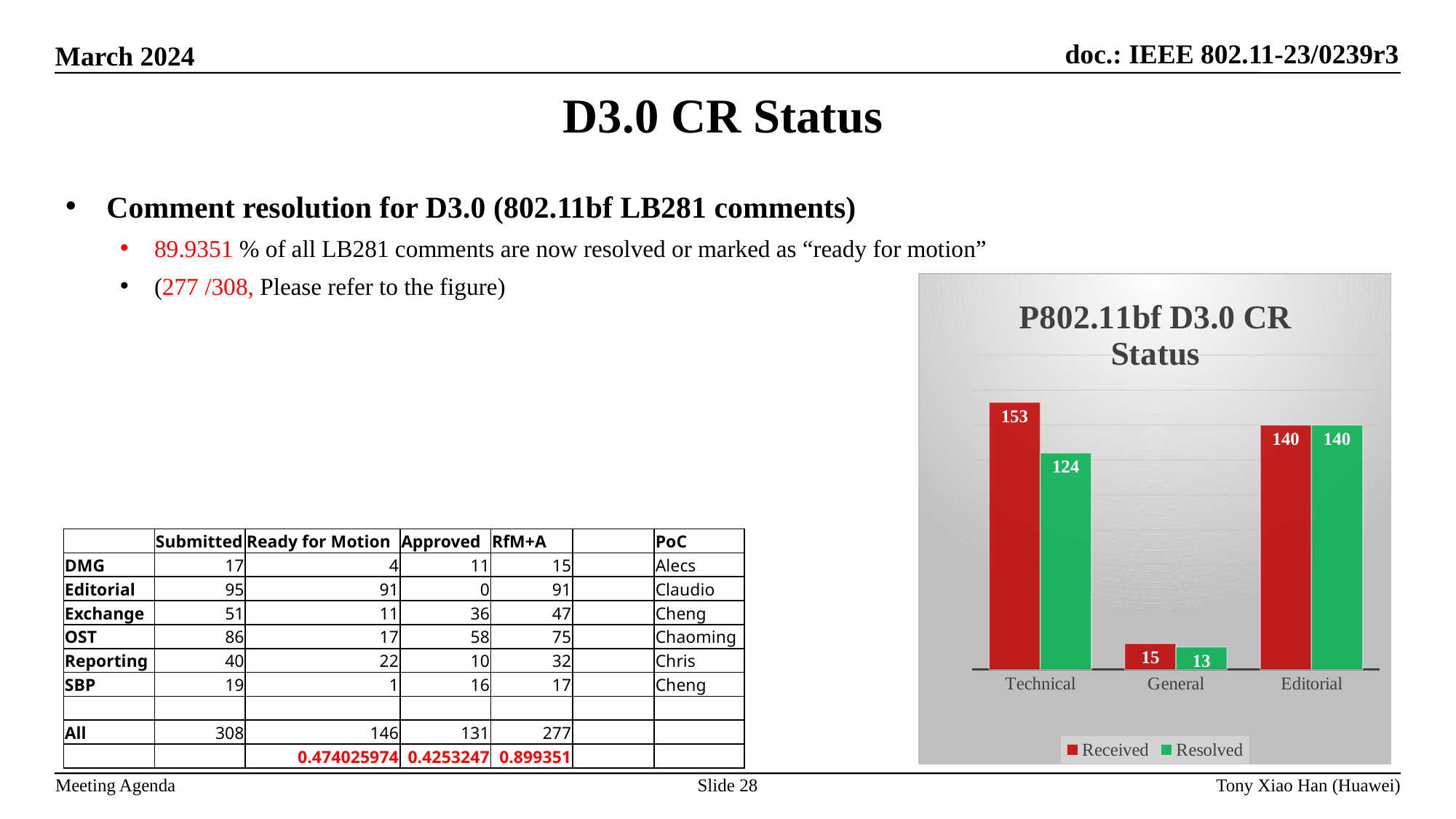
What is the Resolved value for Technical in the chart? 124 Is the Received value for Technical larger or the Received value for Editorial? Technical What is the difference between Received and Resolved for Technical in the chart? 29 What is the difference between Received and Resolved for General in the chart? 2 How many series does the chart legend list? 2 Which category has the lowest Resolved value in the chart? General Which category has the highest Received value in the chart? Technical How many categories are shown on the x axis of the chart? 3 What is the Resolved value for Editorial in the chart? 140 What is the Received value for General in the chart? 15 What is the Received value for Technical in the chart? 153 What type of chart is shown on the slide? Bar chart